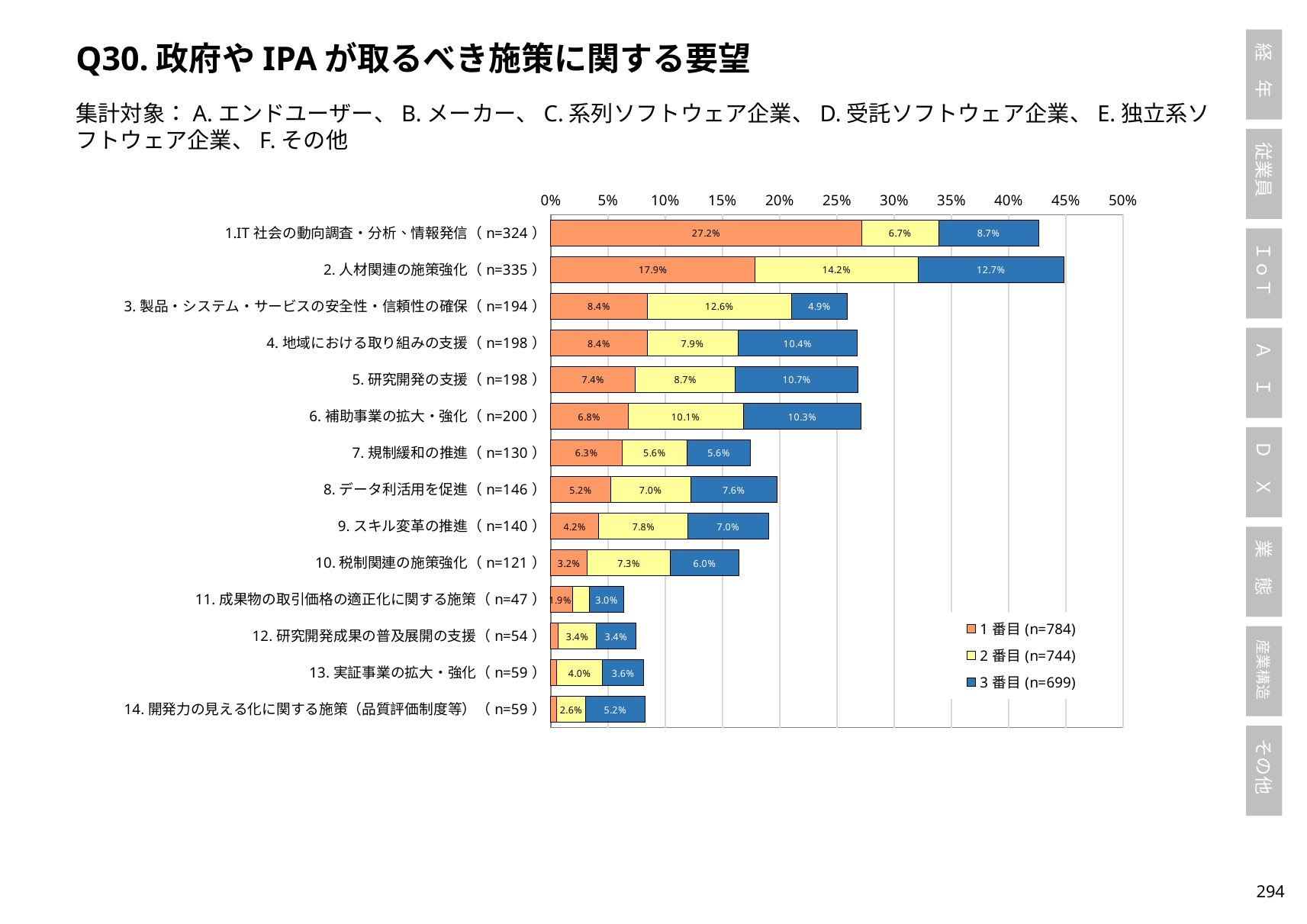
What kind of chart is shown on the slide? Stacked bar chart What is the total of the stacked bar for 2. 人材関連の施策強化 (n=335)? 44.8% Which category has the highest 1番目 value? 1.IT社会の動向調査・分析、情報発信 (n=324) What is the total of the stacked bar for 1.IT社会の動向調査・分析、情報発信 (n=324)? 42.6% Is the total length of the stacked bar for 6. 補助事業の拡大・強化 (n=200) greater or less than 25%? greater What is the 2番目 value for 2. 人材関連の施策強化 (n=335)? 14.2% How many categories (施策) are plotted in the chart? 14 How many series does the legend list? 3 What is the difference between the 1番目 values of 1.IT社会の動向調査・分析、情報発信 and 2. 人材関連の施策強化? 9.3% What is the 1番目 value for 1.IT社会の動向調査・分析、情報発信 (n=324)? 27.2% Which is larger: the 2番目 value for 3. 製品・システム・サービスの安全性・信頼性の確保 or the 2番目 value for 4. 地域における取り組みの支援? 3. 製品・システム・サービスの安全性・信頼性の確保 What is the 3番目 value for 5. 研究開発の支援 (n=198)? 10.7%